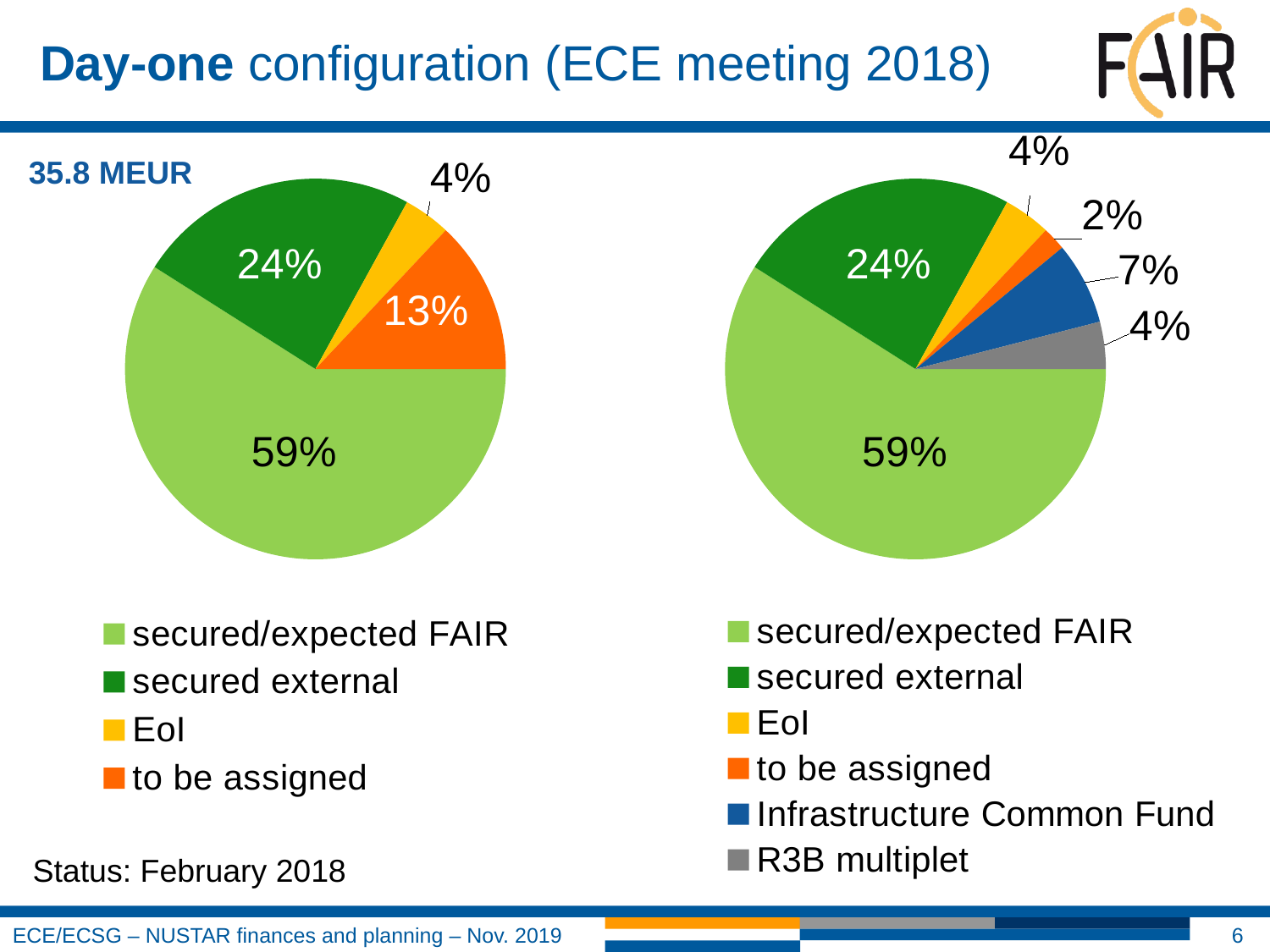
What total amount is stated next to the left pie chart? 35.8 MEUR In the left pie chart, what share is to be assigned? 13% In the right pie chart, what share is Infrastructure Common Fund? 7% What kind of chart is the left chart on the slide? pie chart In the left pie chart, what is the difference between the secured external share and the to be assigned share? 11% In the right pie chart, what share is to be assigned? 2% In the right pie chart, which is larger: the Infrastructure Common Fund share or the R3B multiplet share? Infrastructure Common Fund In the left pie chart, which category has the smallest share? EoI How many categories does the legend of the right pie chart list? 6 In the left pie chart, which category has the largest share? secured/expected FAIR